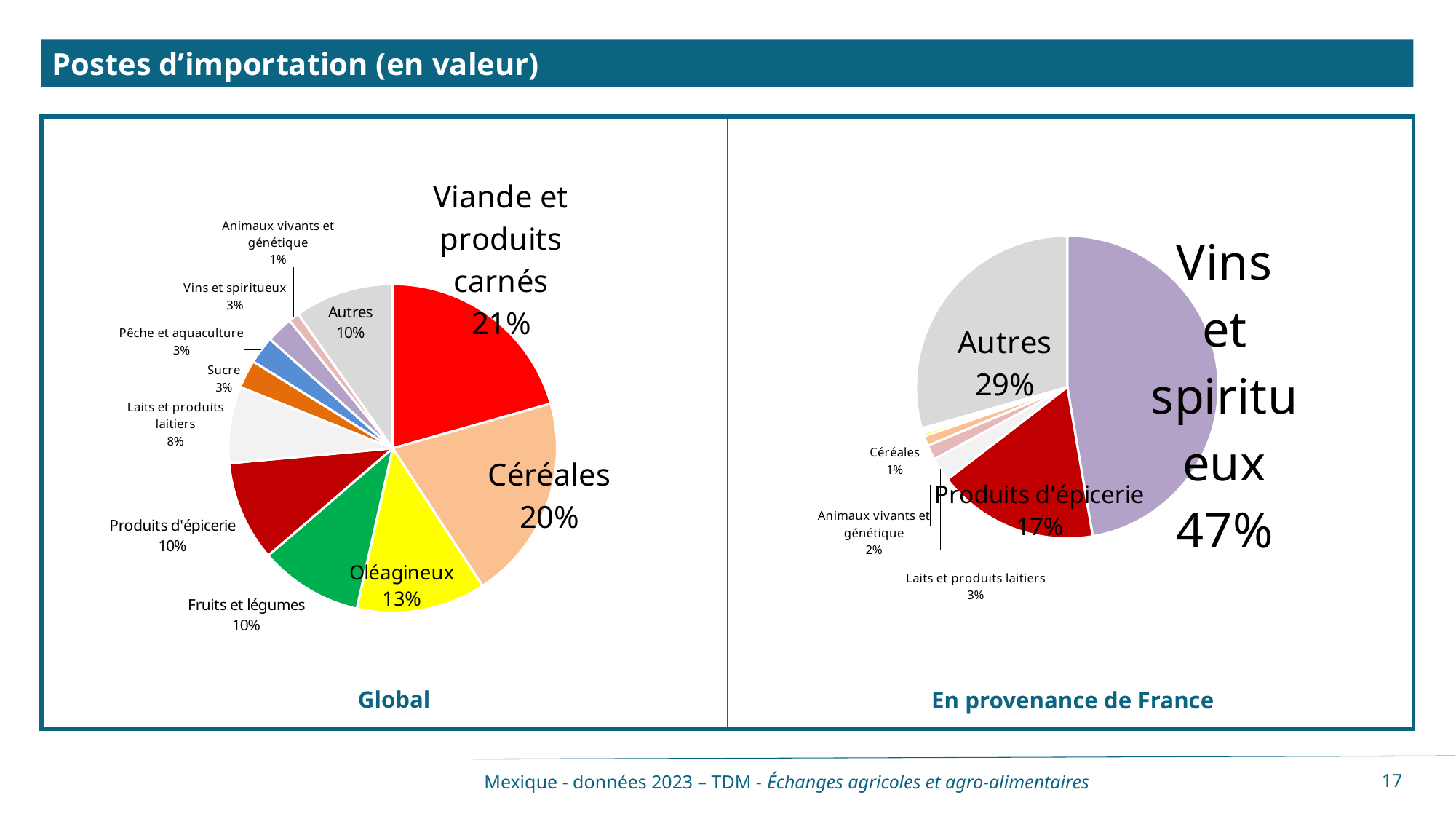
In the Global chart, what is the difference in percentage points between Céréales and Oléagineux? 7 In the Global chart, what share of imports is Laits et produits laitiers? 8% In the Global chart, what share of imports is Oléagineux? 13% In the Global chart, which category has the smallest share? Animaux vivants et génétique In the En provenance de France chart, what share of imports is Produits d'épicerie? 17% In the Global chart, how many slices does the pie have? 11 In the Global chart, what share of imports is Céréales? 20% In the Global chart, what share of imports is Viande et produits carnés? 21% In the En provenance de France chart, what share of imports is Vins et spiritueux? 47% What type of chart is used on this slide? Pie chart In the Global chart, which category has the largest share? Viande et produits carnés In the En provenance de France chart, which is larger: Autres or Produits d'épicerie? Autres